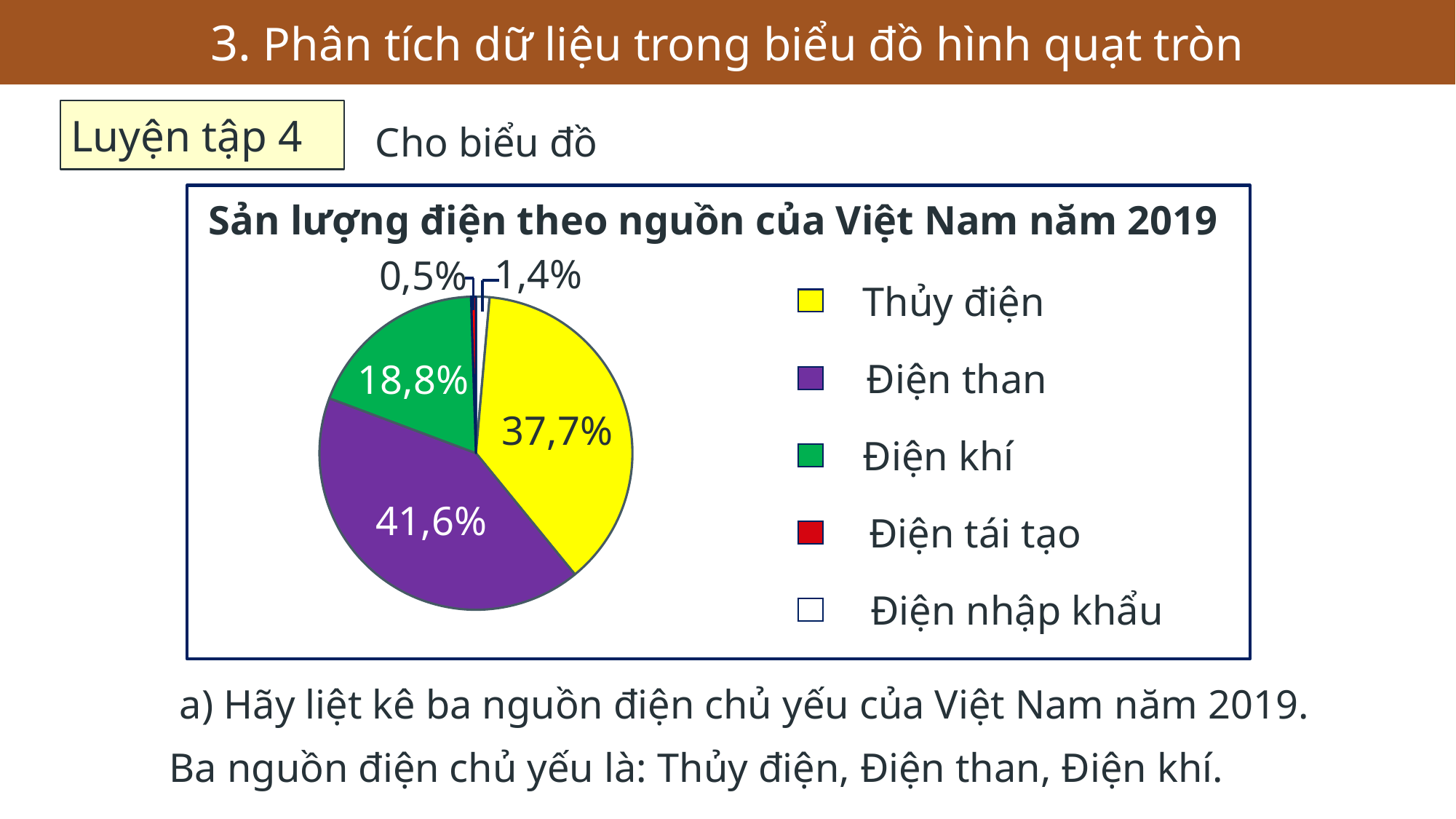
What share of the pie does Điện tái tạo have? 0,5% What share of the pie does Điện khí have? 18,8% How many slices does the pie chart have? 5 What share of the pie does Điện than have? 41,6% What share of the pie does Điện nhập khẩu have? 1,4% What kind of chart is shown on the slide? Pie chart What share of the pie does Thủy điện have? 37,7% What is the title of the chart? Sản lượng điện theo nguồn của Việt Nam năm 2019 Which has a larger share, Thủy điện or Điện khí? Thủy điện Which source has the largest share of the pie? Điện than Which source has the smallest share of the pie? Điện tái tạo What is the difference between the shares of Điện than and Thủy điện? 3,9%